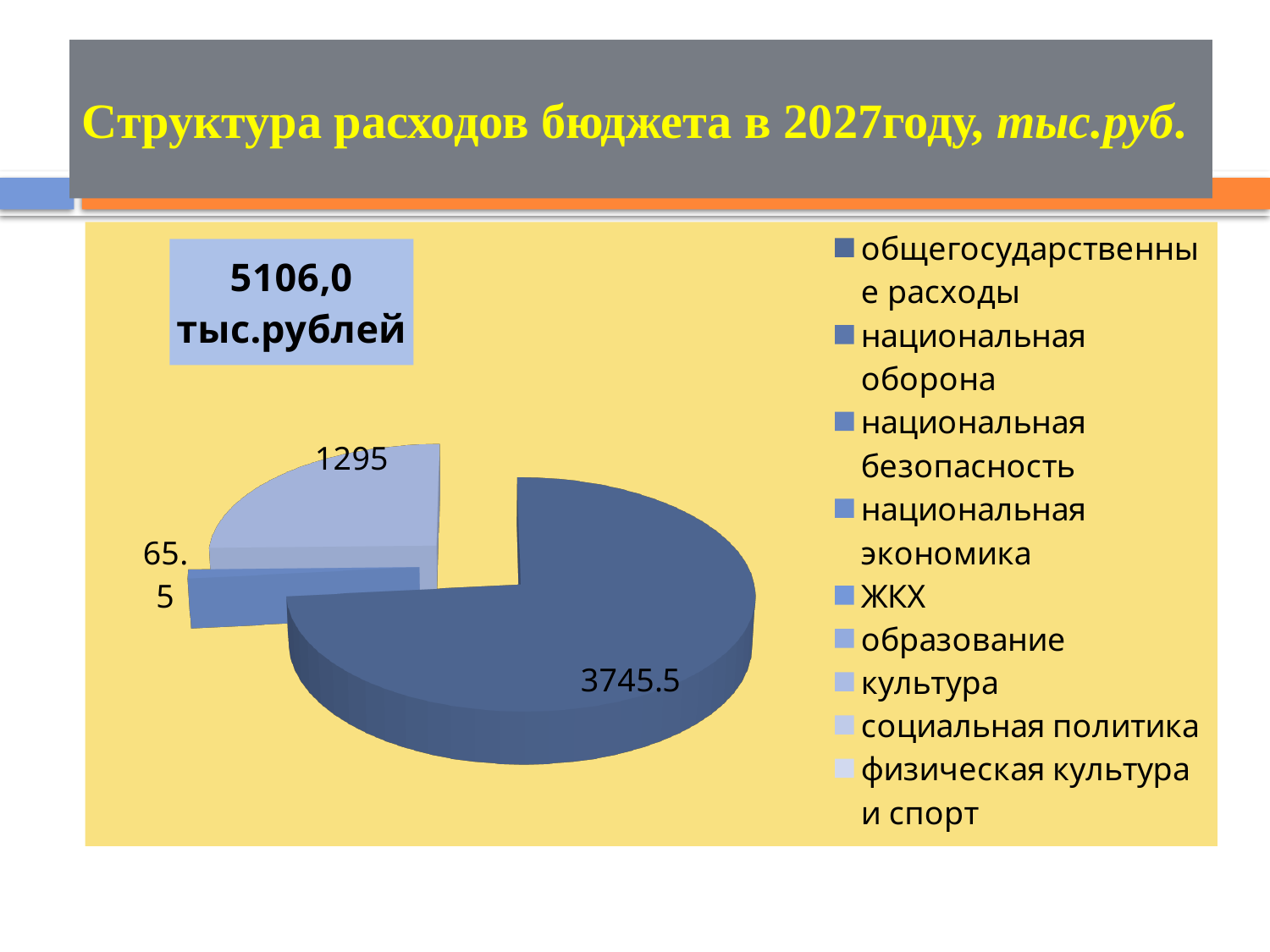
What is the sum of the three values printed on the pie chart slices? 5106 What is the title of the slide? Структура расходов бюджета в 2027году, тыс.руб. What is the difference between the slice labelled 3745.5 and the slice labelled 1295? 2450.5 What is the smallest value printed on a slice of the pie chart? 65.5 What total amount is shown in the box above the pie chart? 5106,0 тыс.рублей Which is larger: the slice labelled 1295 or the slice labelled 65.5? 1295 How many slices of the pie chart have a printed data label? 3 Which category does the largest slice of the pie chart represent? общегосударственные расходы What is the value printed on the largest slice of the pie chart? 3745.5 What kind of chart is shown on the slide? pie chart How many entries does the legend of the pie chart list? 9 What is the difference between the slice labelled 1295 and the slice labelled 65.5? 1229.5